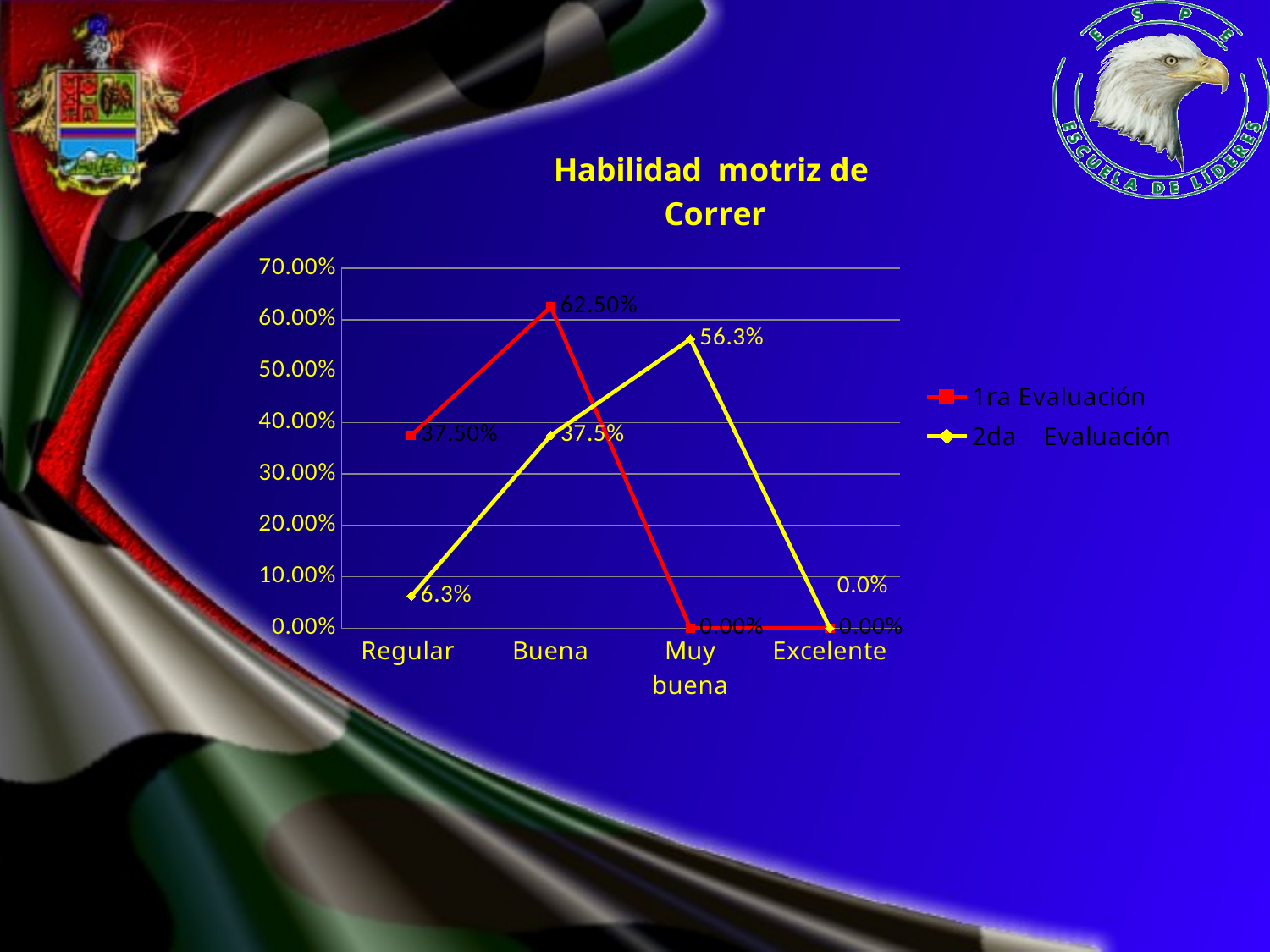
What is the value for Muy buena in the 2da Evaluación series? 56.3% How many series does the legend list? 2 What is the value for Excelente in the 1ra Evaluación series? 0.00% Which category has the highest value in the 2da Evaluación series? Muy buena What type of chart is shown on the slide? line chart How many categories are shown on the x axis? 4 What is the difference between the 1ra Evaluación and 2da Evaluación values for Regular? 31.2% What is the value for Regular in the 2da Evaluación series? 6.3% Which category has the highest value in the 1ra Evaluación series? Buena What is the title of the chart? Habilidad motriz de Correr For Buena, which series has the larger value, 1ra Evaluación or 2da Evaluación? 1ra Evaluación What is the value for Buena in the 1ra Evaluación series? 62.50%